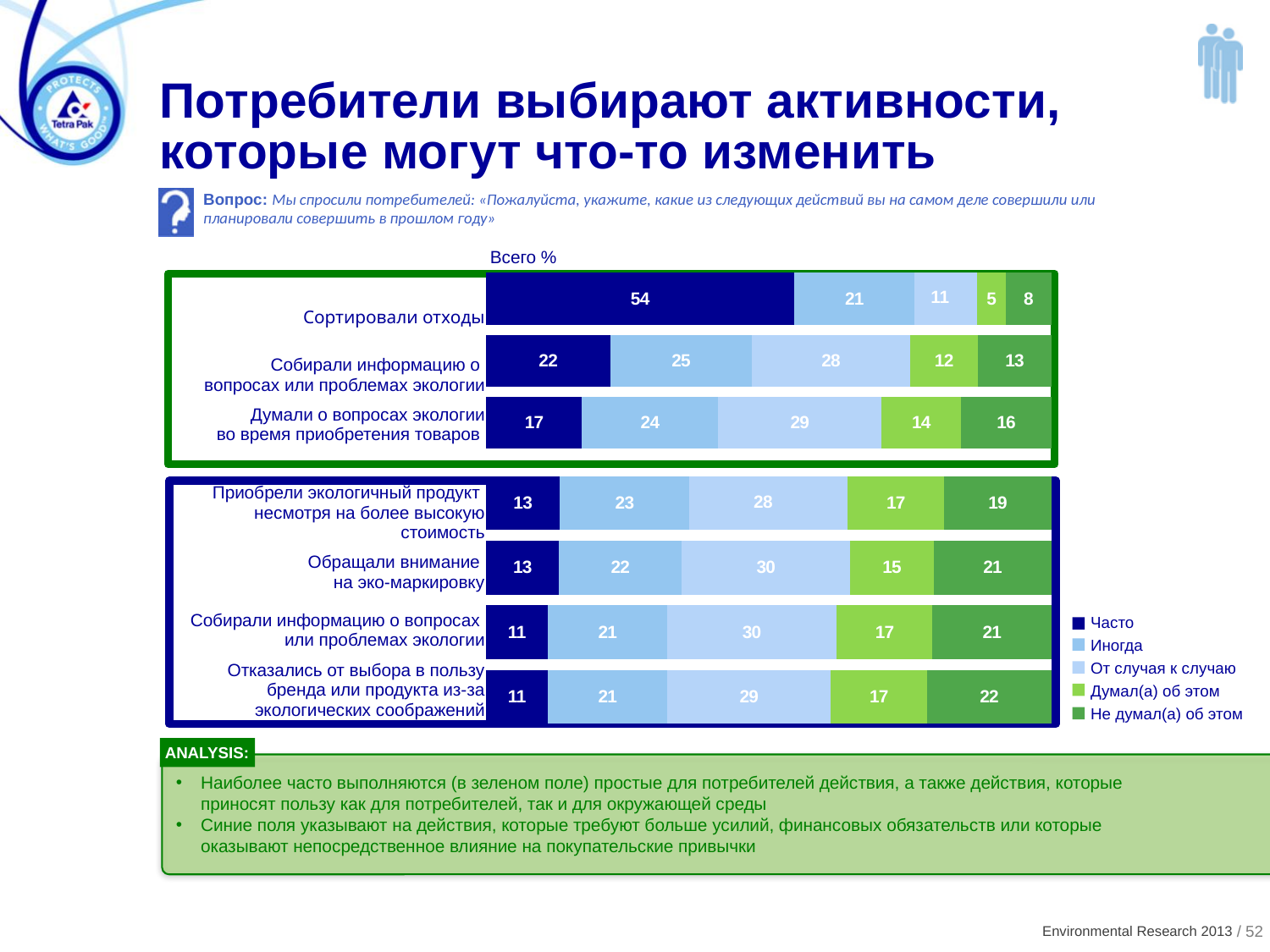
What is the first entry in the chart legend? Часто What is the value for "Не думал(а) об этом" in the "Отказались от выбора в пользу бренда или продукта из-за экологических соображений" bar? 22 What kind of chart is shown on the slide? Stacked bar chart What is the total of the stacked bar for "Сортировали отходы"? 99 Which is larger: the "Иногда" value for "Сортировали отходы" or the "Иногда" value for "Думали о вопросах экологии во время приобретения товаров"? Думали о вопросах экологии во время приобретения товаров Which category has the lowest value for "Не думал(а) об этом"? Сортировали отходы How many categories (bars) are shown in the chart? 7 What is the difference between the "Часто" value for "Сортировали отходы" and the "Часто" value for "Думали о вопросах экологии во время приобретения товаров"? 37 What is the value for "От случая к случаю" in the "Обращали внимание на эко-маркировку" bar? 30 Which category has the highest value for "Часто"? Сортировали отходы How many series does the legend list? 5 What is the value for "Часто" in the "Сортировали отходы" bar? 54